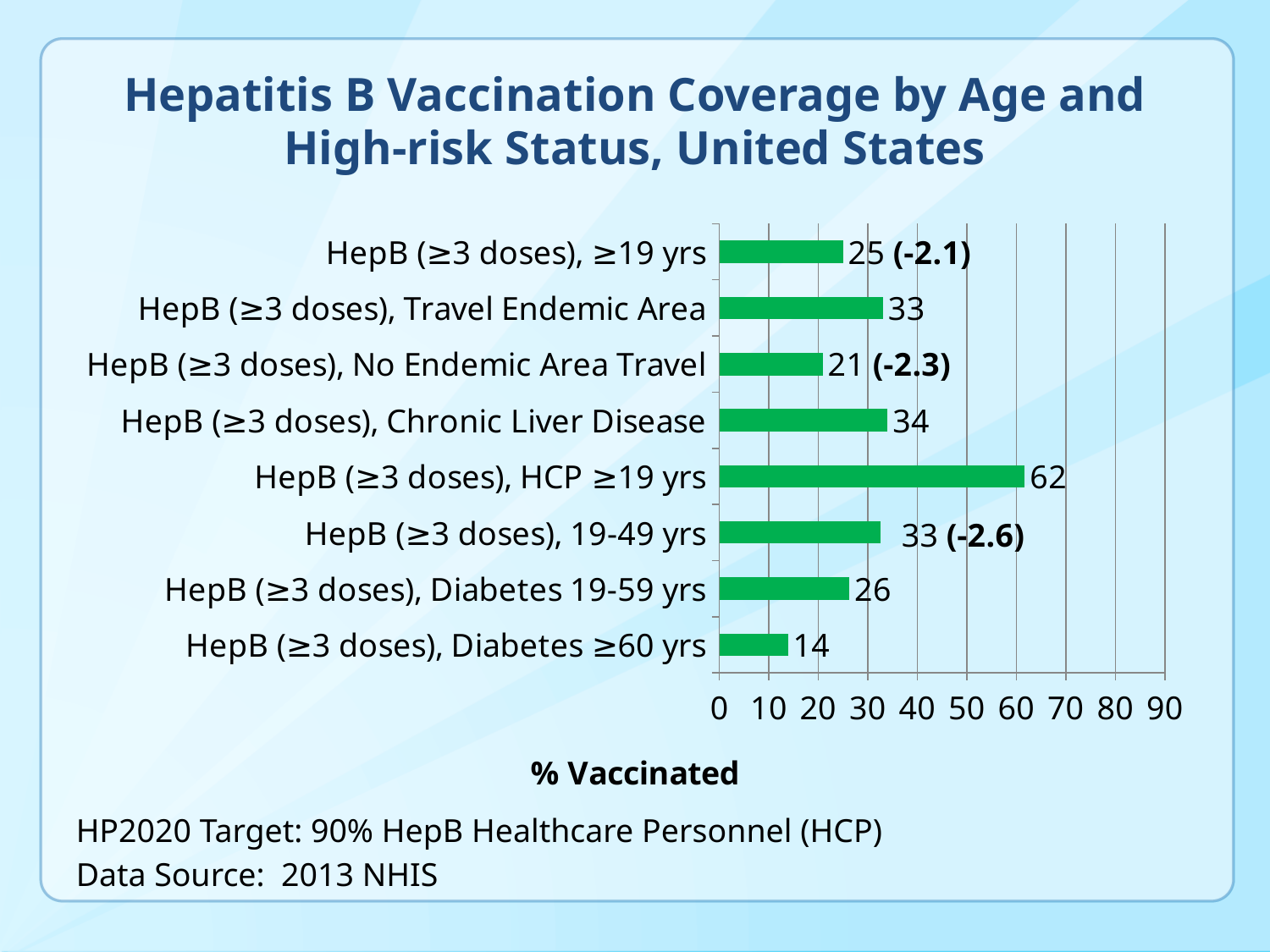
What is the value for HepB (≥3 doses), No Endemic Area Travel? 21 What is the difference between the values for HepB (≥3 doses), HCP ≥19 yrs and HepB (≥3 doses), Diabetes ≥60 yrs? 48 What is the value for HepB (≥3 doses), HCP ≥19 yrs? 62 Which category has the highest value? HepB (≥3 doses), HCP ≥19 yrs Is the value for HepB (≥3 doses), HCP ≥19 yrs greater or less than 50? greater What is the label of the horizontal axis? % Vaccinated What is the value for HepB (≥3 doses), Chronic Liver Disease? 34 What kind of chart is shown on the slide? bar chart Which is larger, the value for HepB (≥3 doses), Travel Endemic Area or HepB (≥3 doses), No Endemic Area Travel? HepB (≥3 doses), Travel Endemic Area Which category has the lowest value? HepB (≥3 doses), Diabetes ≥60 yrs What is the value for HepB (≥3 doses), Diabetes ≥60 yrs? 14 How many categories are shown in the chart? 8